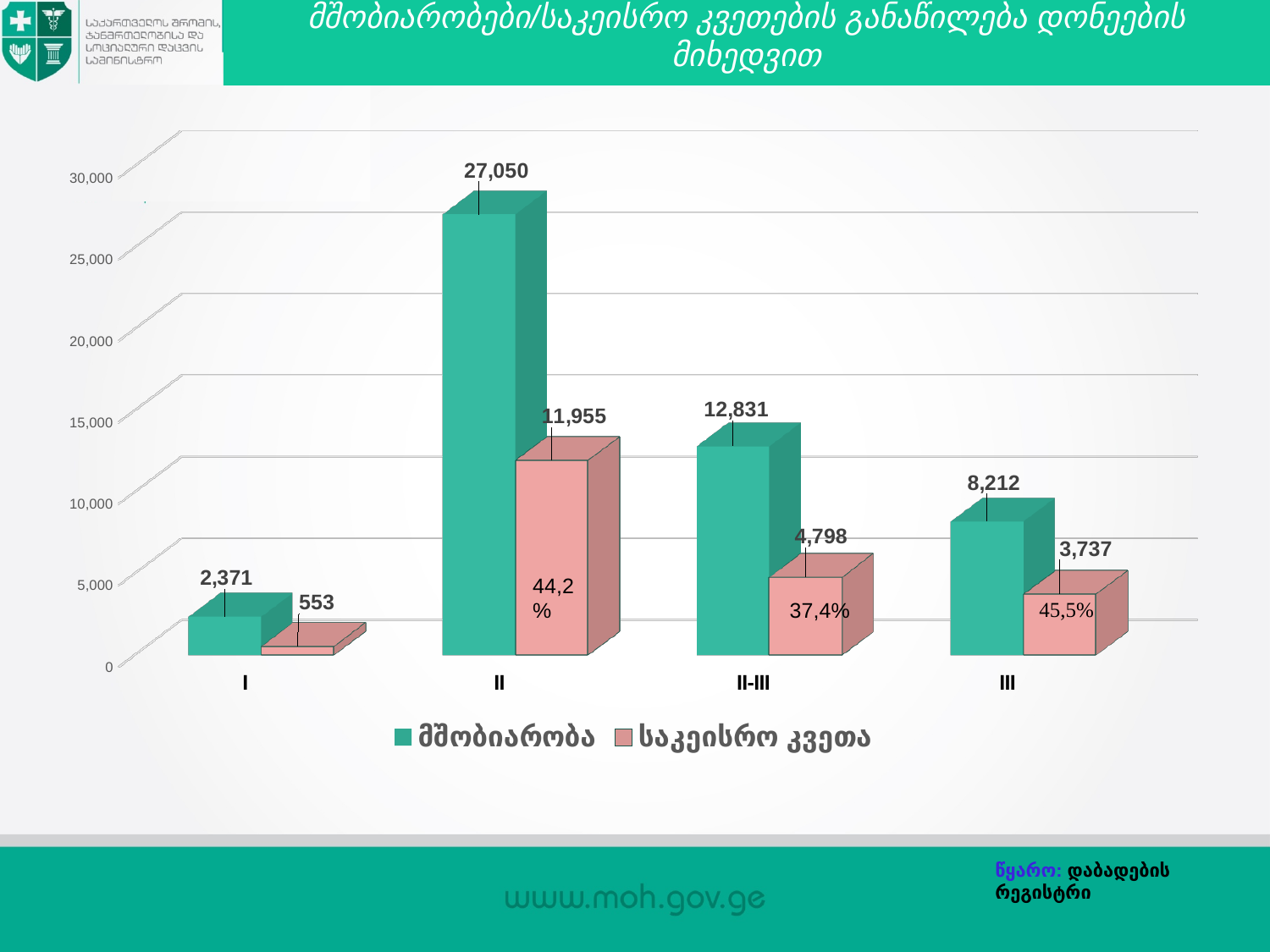
Which category has the lowest value for საკეისრო კვეთა? I What is the value for საკეისრო კვეთა in category II-III? 4,798 What kind of chart is shown on the slide? Bar chart What is the difference between მშობიარობა and საკეისრო კვეთა in category II? 15,095 What is the value for საკეისრო კვეთა in category I? 553 What is the value for მშობიარობა in category III? 8,212 What percentage label is shown on the საკეისრო კვეთა bar for category III? 45,5% Which category has the highest value for მშობიარობა? II Which is larger: მშობიარობა in category II-III or მშობიარობა in category III? მშობიარობა in category II-III What is the value for მშობიარობა in category II? 27,050 How many categories are shown on the x axis? 4 How many series does the legend list? 2